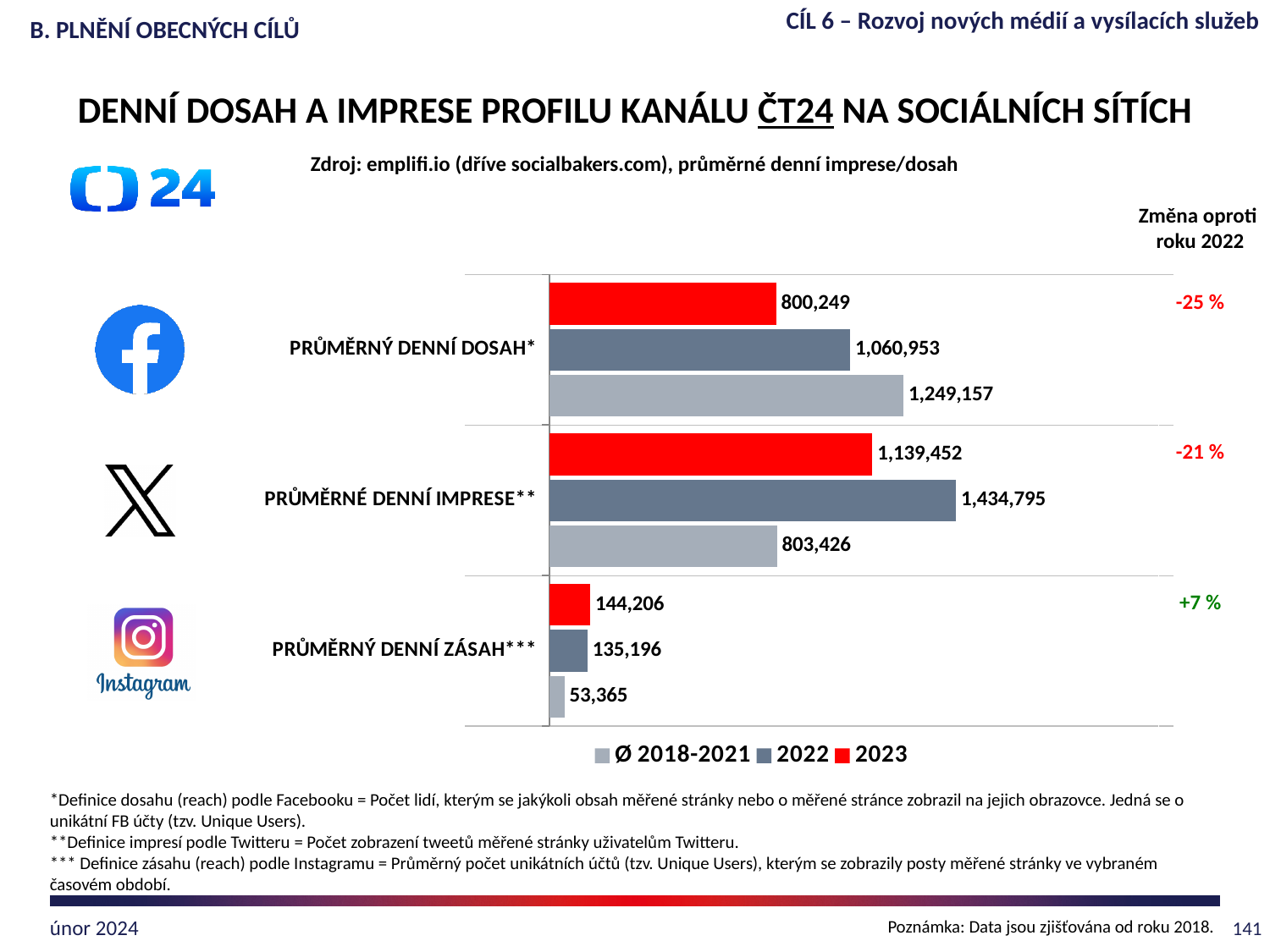
What is the Ø 2018-2021 value for PRŮMĚRNÝ DENNÍ ZÁSAH*** (Instagram)? 53,365 Which category has the highest 2022 value? PRŮMĚRNÉ DENNÍ IMPRESE** What is the change versus 2022 shown for PRŮMĚRNÝ DENNÍ ZÁSAH*** (Instagram)? +7 % What is the difference between the 2022 and 2023 values for PRŮMĚRNÝ DENNÍ DOSAH*? 260,704 For PRŮMĚRNÉ DENNÍ IMPRESE**, which is larger: the 2023 value or the Ø 2018-2021 value? 2023 What is the 2023 value for PRŮMĚRNÝ DENNÍ DOSAH* (Facebook)? 800,249 What is the Ø 2018-2021 value for PRŮMĚRNÝ DENNÍ DOSAH* (Facebook)? 1,249,157 What kind of chart is shown on the slide? Bar chart What is the 2022 value for PRŮMĚRNÉ DENNÍ IMPRESE** (X)? 1,434,795 How many series does the legend list? 3 How many categories are shown in the chart? 3 Which category has the lowest 2023 value? PRŮMĚRNÝ DENNÍ ZÁSAH***